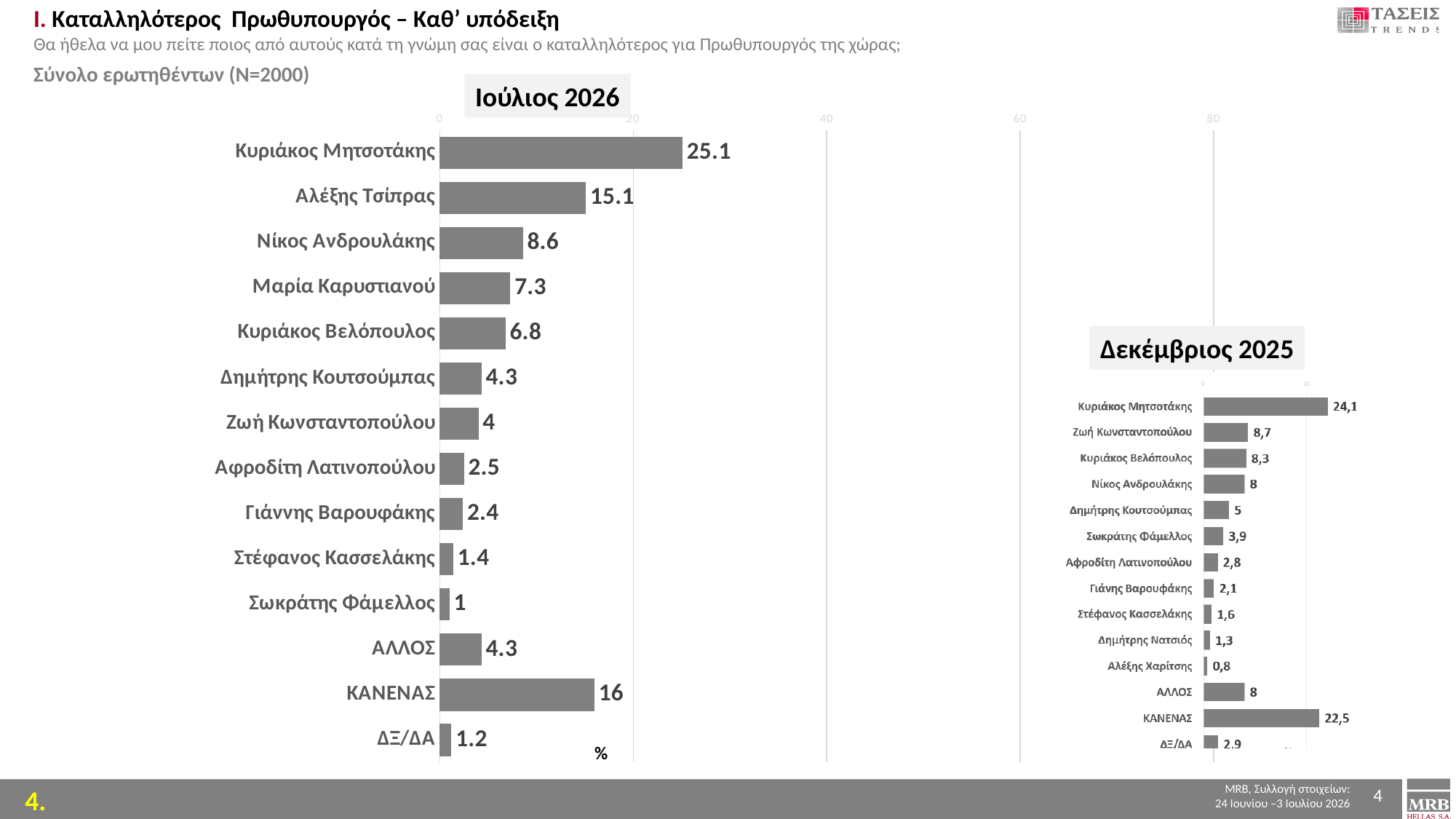
In the Δεκέμβριος 2025 chart, which is larger: the value for Κυριάκος Βελόπουλος or Δημήτρης Κουτσούμπας? Κυριάκος Βελόπουλος In the Ιούλιος 2026 chart, what is the difference between the values for Κυριάκος Μητσοτάκης and Αλέξης Τσίπρας? 10 In the Ιούλιος 2026 chart, how many categories are shown? 14 In the Ιούλιος 2026 chart, what is the value for Κυριάκος Μητσοτάκης? 25.1 In the Δεκέμβριος 2025 chart, which category has the lowest value? Αλέξης Χαρίτσης In the Ιούλιος 2026 chart, which is larger: the value for Νίκος Ανδρουλάκης or Μαρία Καρυστιανού? Νίκος Ανδρουλάκης In the Ιούλιος 2026 chart, which category has the highest value? Κυριάκος Μητσοτάκης In the Ιούλιος 2026 chart, which category has the lowest value? Σωκράτης Φάμελλος What kind of chart is the Ιούλιος 2026 chart? Bar chart In the Ιούλιος 2026 chart, what is the value for ΚΑΝΕΝΑΣ? 16 In the Δεκέμβριος 2025 chart, what is the value for ΚΑΝΕΝΑΣ? 22,5 In the Δεκέμβριος 2025 chart, what is the value for Ζωή Κωνσταντοπούλου? 8,7